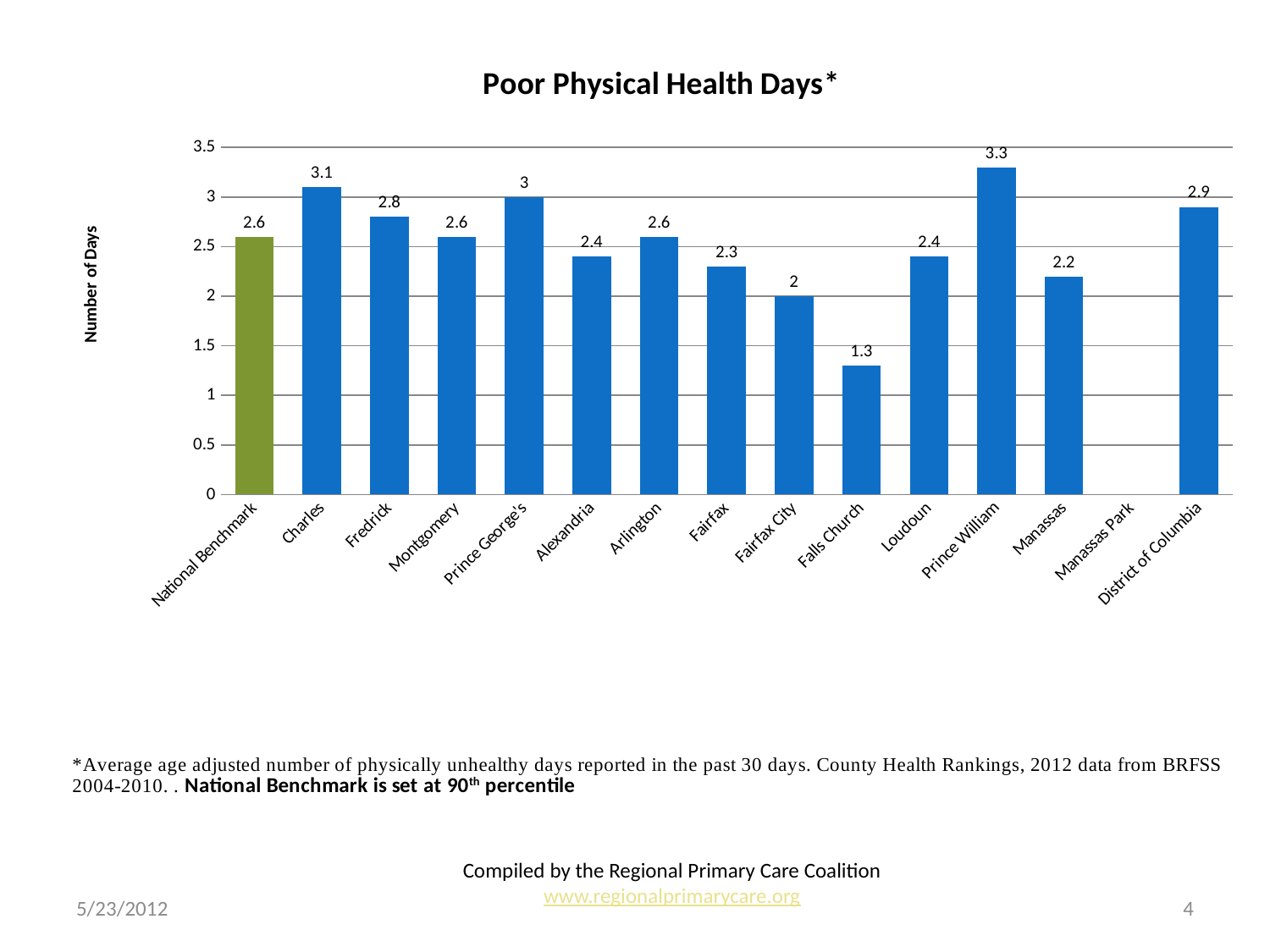
Which is larger, the value for Fredrick or the value for District of Columbia? District of Columbia What is the title of the vertical axis? Number of Days Which plotted category has the lowest value? Falls Church What is the value shown for the National Benchmark? 2.6 What is the value for Charles in the Poor Physical Health Days chart? 3.1 Which category has the highest value? Prince William Is the value for Prince William greater or less than 3? greater What is the value for District of Columbia? 2.9 How many categories are labeled on the x axis? 15 What is the value for Falls Church? 1.3 What is the difference between the values for Charles and Fairfax City? 1.1 What kind of chart is shown on the slide? Bar chart